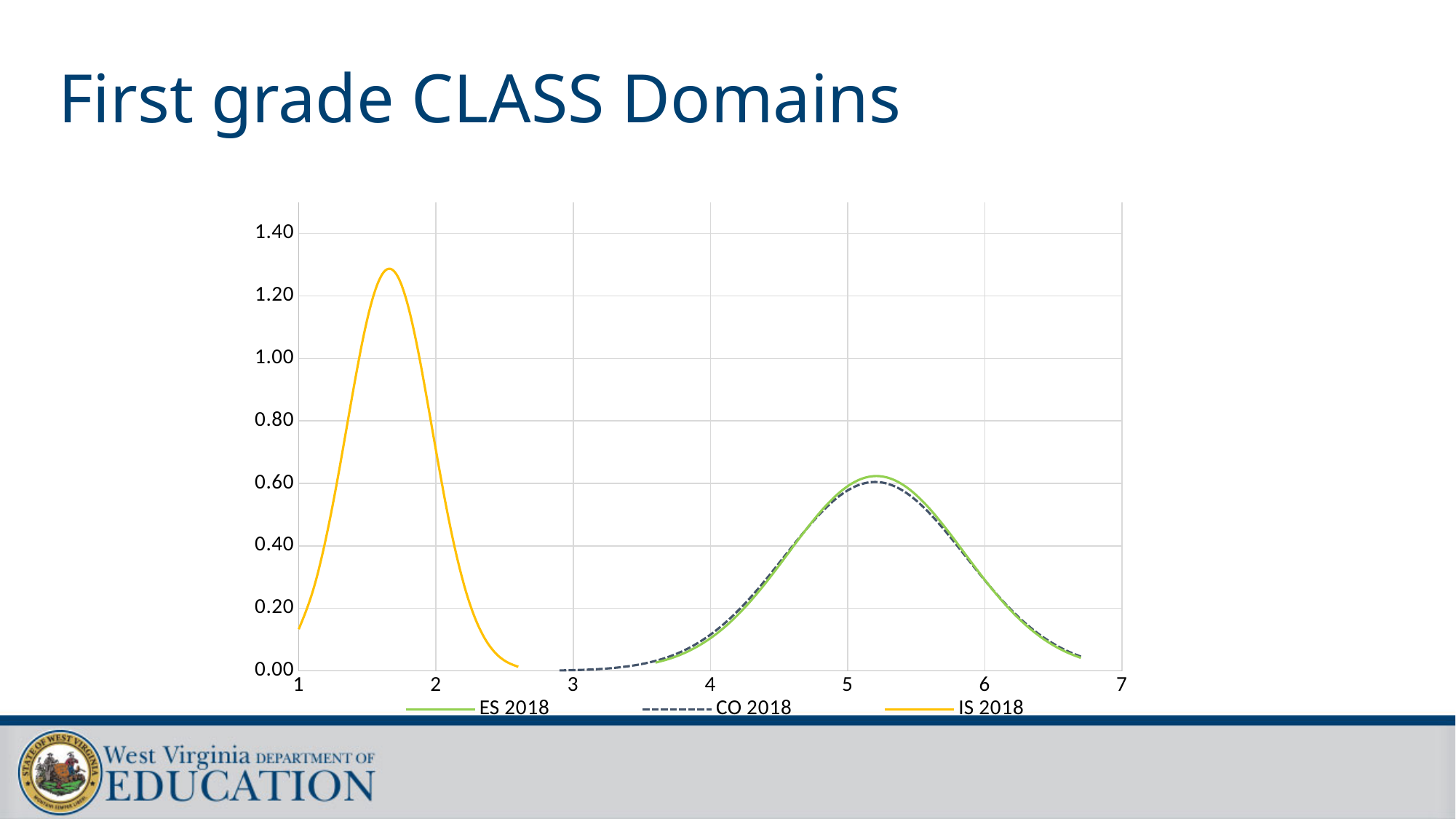
Is the peak value of the IS 2018 curve greater or less than 1.20? greater Is the peak value of the IS 2018 curve greater or less than 1.40? less What kind of chart is shown on the slide? line chart Which series has its peak at the lowest x-axis value? IS 2018 Does the ES 2018 curve rise or fall as x increases from 4 to 5? rise Does the IS 2018 curve rise or fall as x increases from 2 to 2.5? fall How many series does the legend list? 3 Is the peak value of the CO 2018 curve greater or less than 0.40? greater Which series reaches the highest peak value? IS 2018 What is the highest value shown on the x axis? 7 Which series is drawn with a dashed line? CO 2018